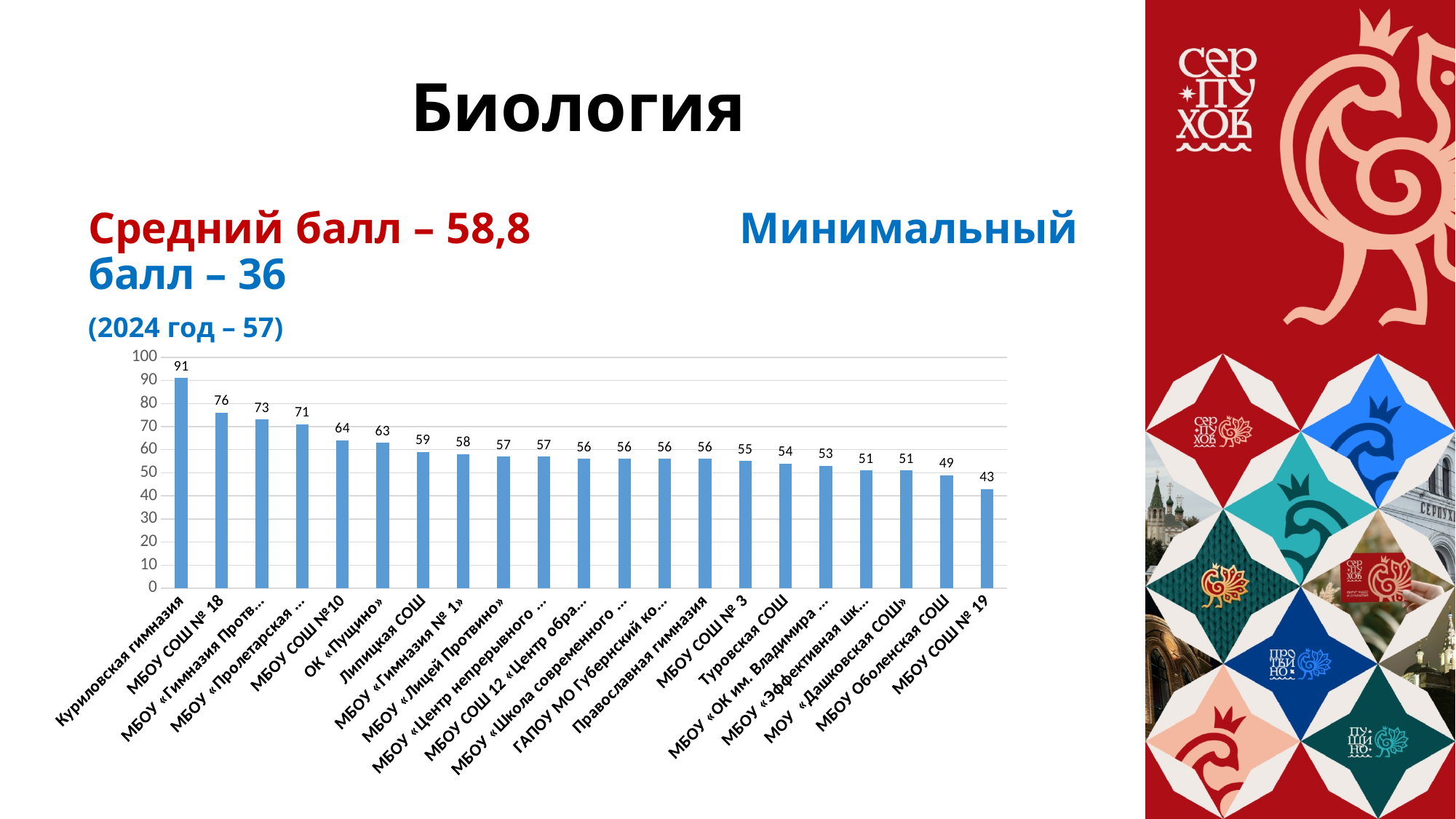
What is the value for ОК «Пущино»? 63 How many categories are shown on the chart? 21 What is the value for МБОУ СОШ № 18? 76 Do the values rise or fall from left to right along the x axis? fall Is the value for МБОУ Оболенская СОШ greater or less than 50? less Which is larger, the value for Липицкая СОШ or the value for Туровская СОШ? Липицкая СОШ What is the value for МБОУ СОШ № 19? 43 What kind of chart is shown on the slide? bar chart What is the difference between the values for Куриловская гимназия and МБОУ СОШ № 18? 15 Which category has the highest value? Куриловская гимназия What is the value for Куриловская гимназия? 91 Which category has the lowest value? МБОУ СОШ № 19